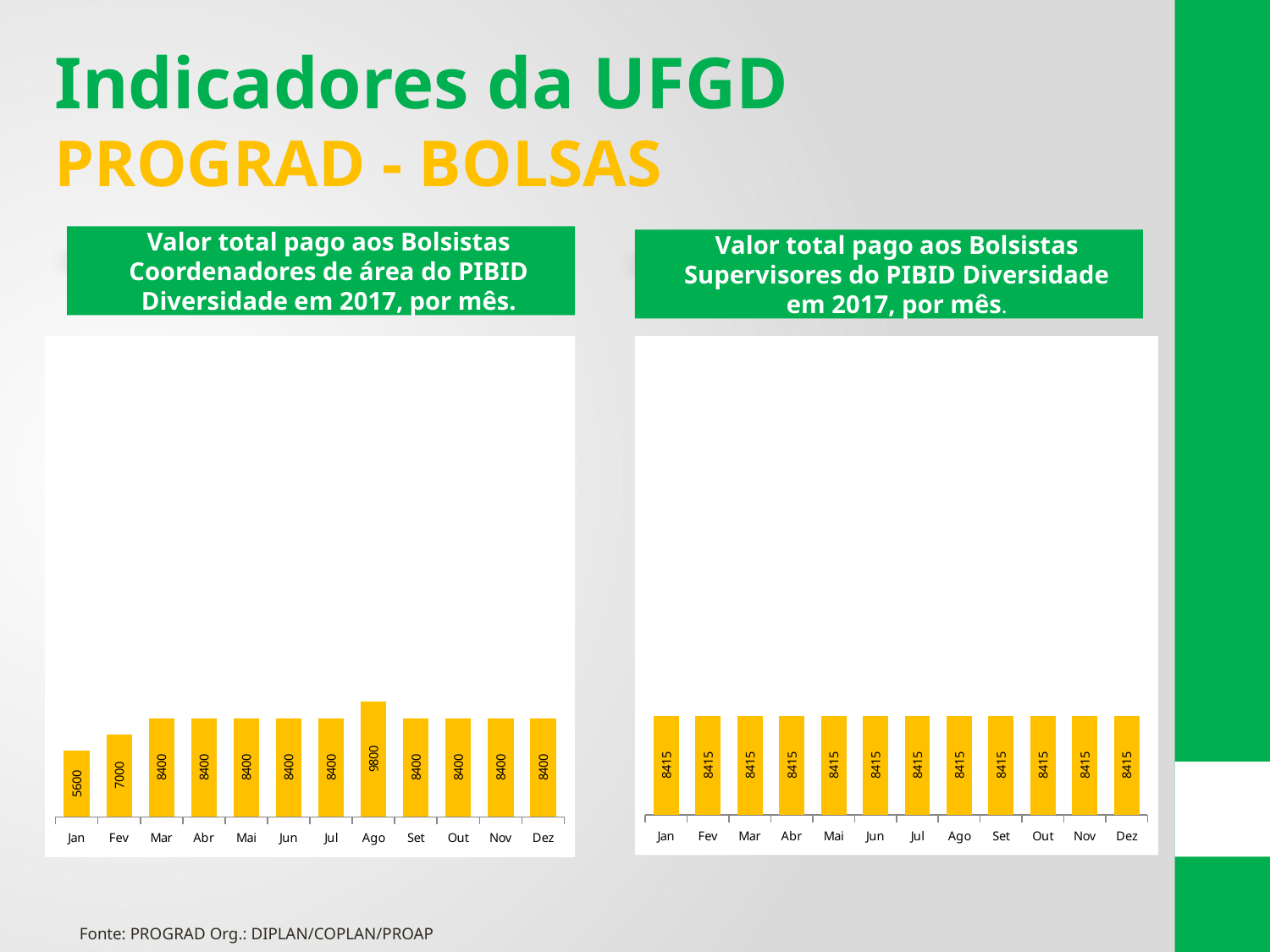
In the left chart (Coordenadores de área), what is the difference between the values for Ago and Jul? 1400 In the right chart (Supervisores), do the values rise, fall, or stay the same across the months? stay the same In the right chart (Supervisores), how many months are plotted? 12 In the right chart (Supervisores), what is the value for Dez? 8415 In the left chart (Coordenadores de área), what is the difference between the values for Fev and Jan? 1400 In the left chart (Coordenadores de área), which month has the highest value? Ago In the left chart (Coordenadores de área), what is the value for Fev? 7000 In the left chart (Coordenadores de área), what is the value for Ago? 9800 In the left chart (Coordenadores de área), which is larger, the value for Fev or the value for Mar? Mar In the left chart (Coordenadores de área), what is the value for Jan? 5600 What kind of chart is the left chart (Coordenadores de área)? bar chart In the left chart (Coordenadores de área), which month has the lowest value? Jan